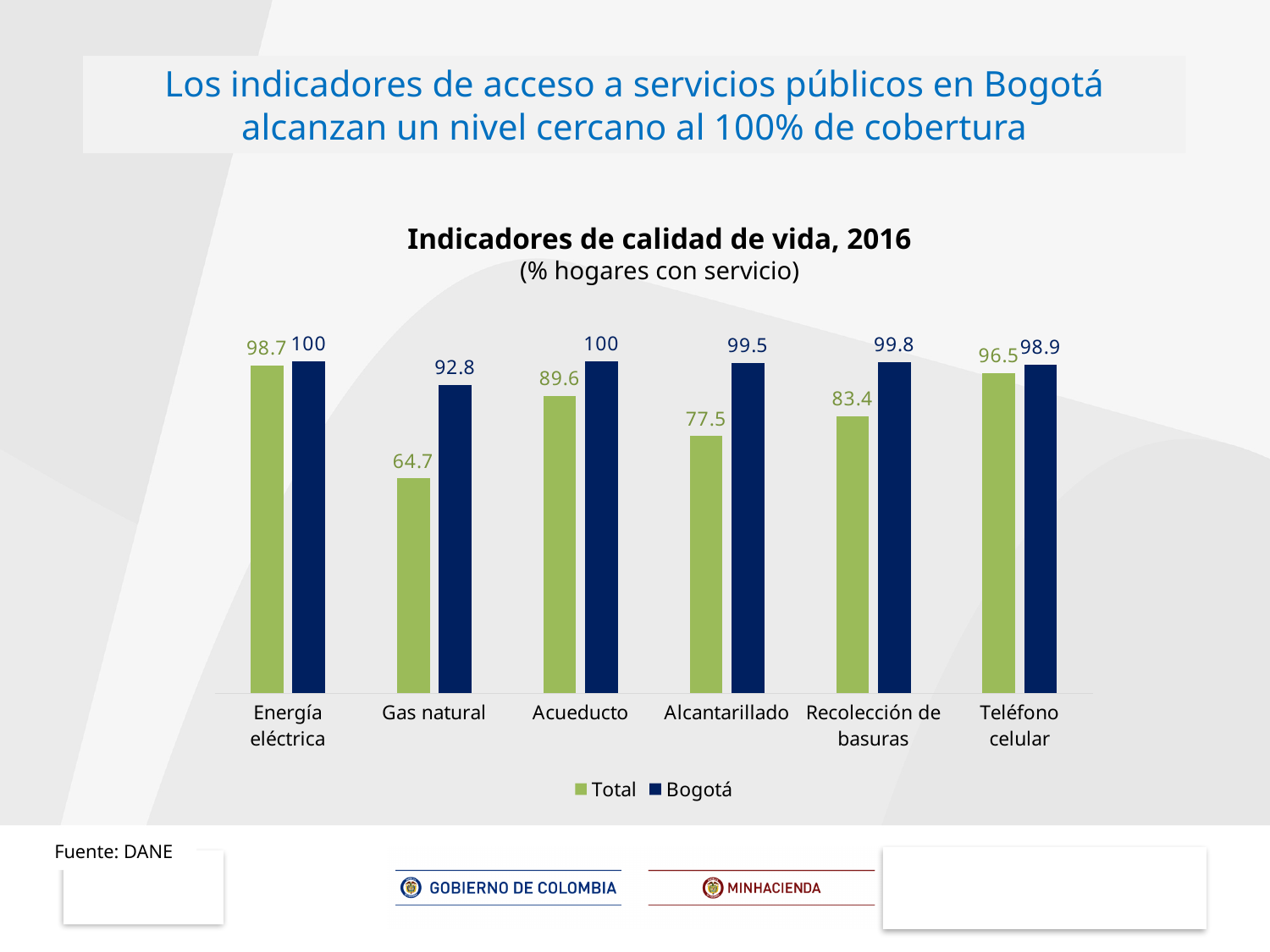
What is the Bogotá value for Teléfono celular? 98.9 What is the Total value for Recolección de basuras? 83.4 What is the difference between the Bogotá and Total values for Alcantarillado? 22 Which category has the highest Total value? Energía eléctrica What is the difference between the Bogotá and Total values for Gas natural? 28.1 How many categories are shown on the x axis? 6 How many series does the legend list? 2 Which is larger, the Total value for Acueducto or the Total value for Alcantarillado? Acueducto Which category has the lowest Total value? Gas natural Which category has the lowest Bogotá value? Gas natural What is the Total value for Gas natural? 64.7 What is the Bogotá value for Alcantarillado? 99.5